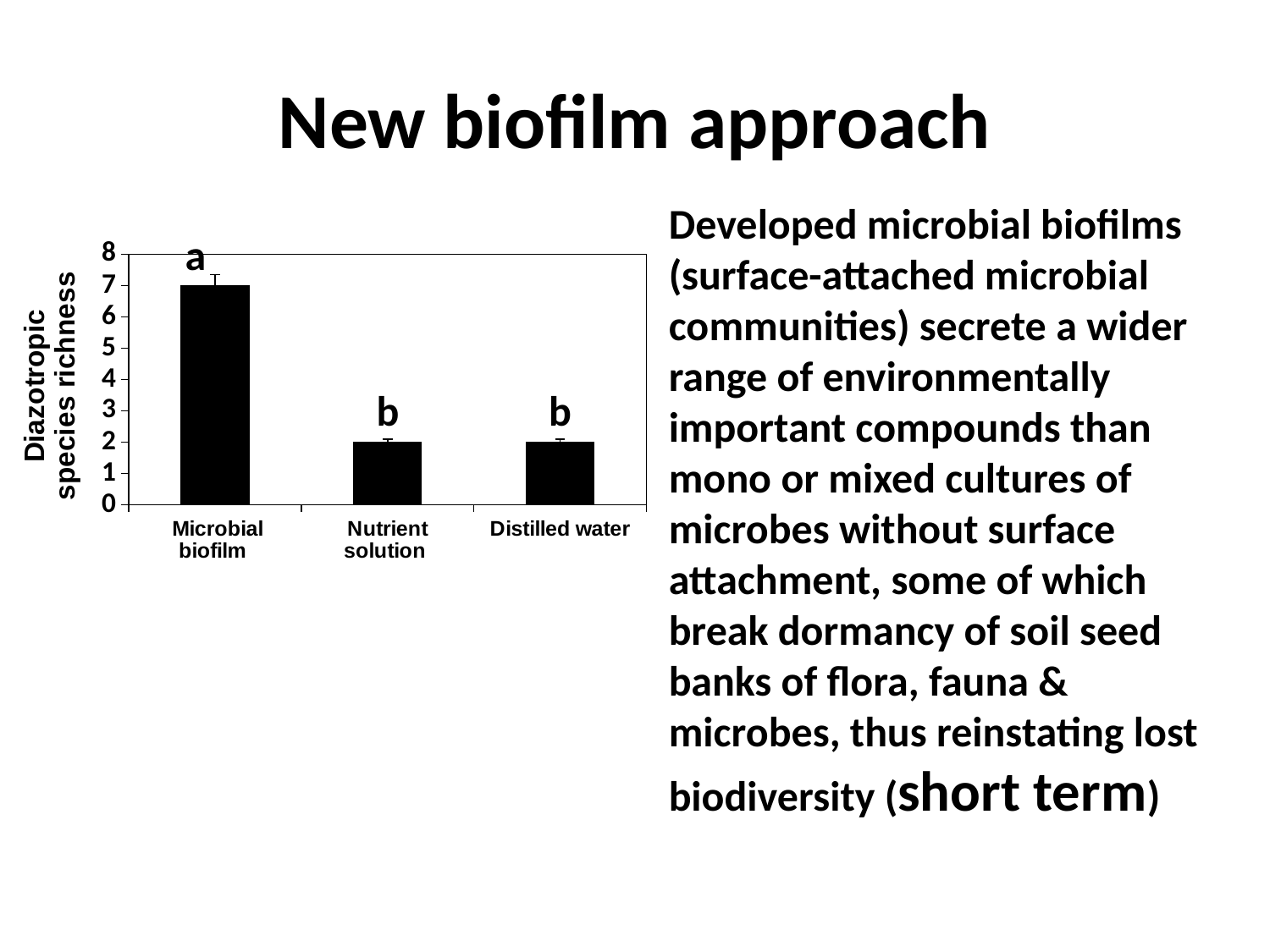
What letter is printed above the Microbial biofilm bar? a What is the diazotropic species richness value for Microbial biofilm? 7 Which category has the highest diazotropic species richness? Microbial biofilm Is the value for Microbial biofilm greater or less than 5? greater What is the difference in diazotropic species richness between Microbial biofilm and Nutrient solution? 5 What is the diazotropic species richness value for Nutrient solution? 2 Is the value for Nutrient solution greater or less than 4? less What kind of chart is shown on the slide? bar chart What is the label on the y axis of the chart? Diazotropic species richness What is the diazotropic species richness value for Distilled water? 2 How many categories are shown on the x axis of the chart? 3 Which has a higher diazotropic species richness, Microbial biofilm or Distilled water? Microbial biofilm